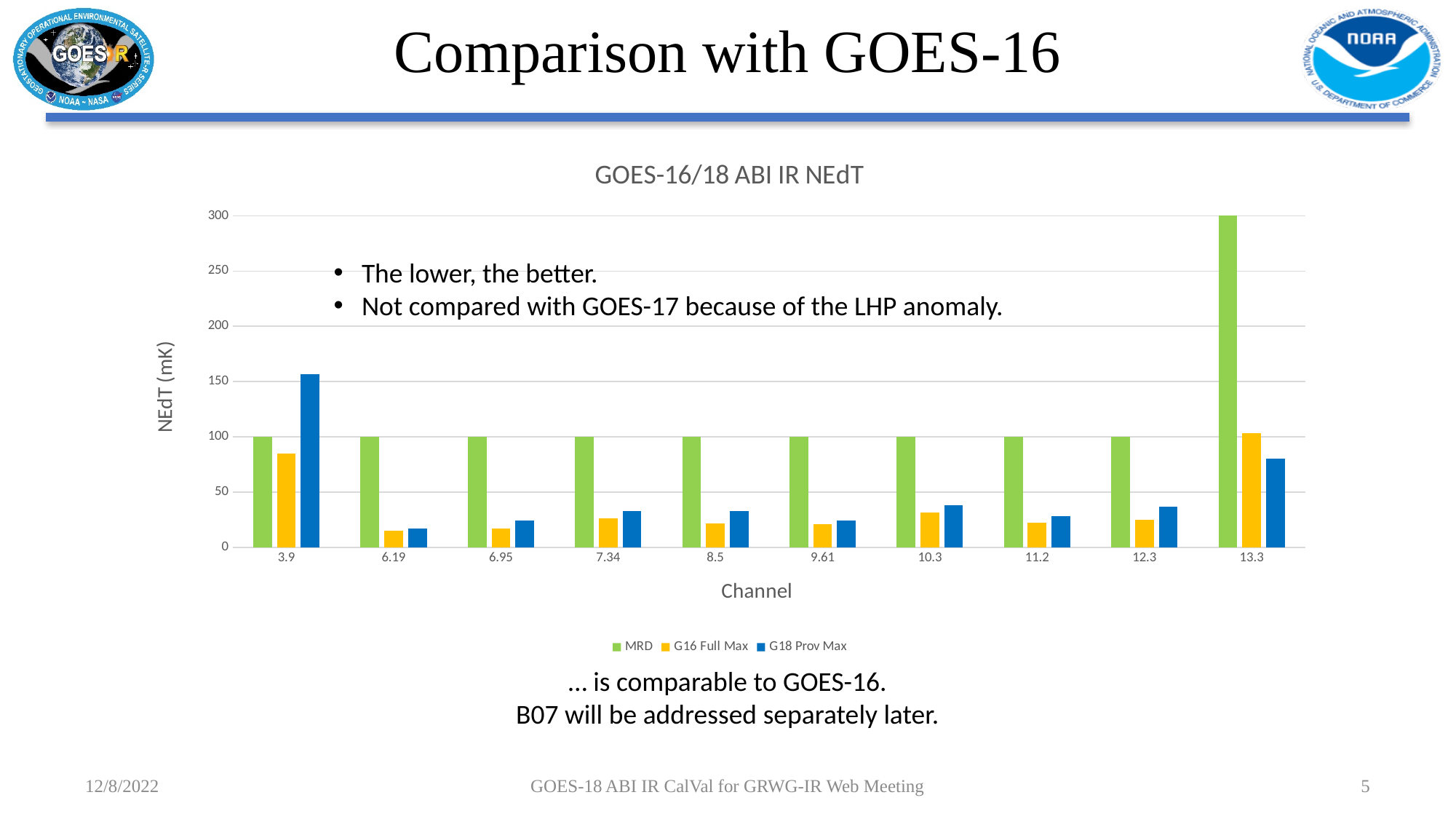
Is the G18 Prov Max value for channel 13.3 greater or less than 100? less What is the MRD value for channel 13.3? 300 What kind of chart is shown on the slide? bar chart What is the difference between the MRD value for channel 13.3 and the MRD value for channel 3.9? 200 Is the G18 Prov Max value for channel 3.9 greater or less than 150? greater Which channel has the highest MRD value? 13.3 For channel 13.3, which is larger: G16 Full Max or G18 Prov Max? G16 Full Max How many series does the chart's legend list? 3 What is the MRD value for channel 6.19? 100 How many channels are shown along the x axis of the chart? 10 What is the title of the chart? GOES-16/18 ABI IR NEdT For channel 3.9, which is larger: G16 Full Max or G18 Prov Max? G18 Prov Max